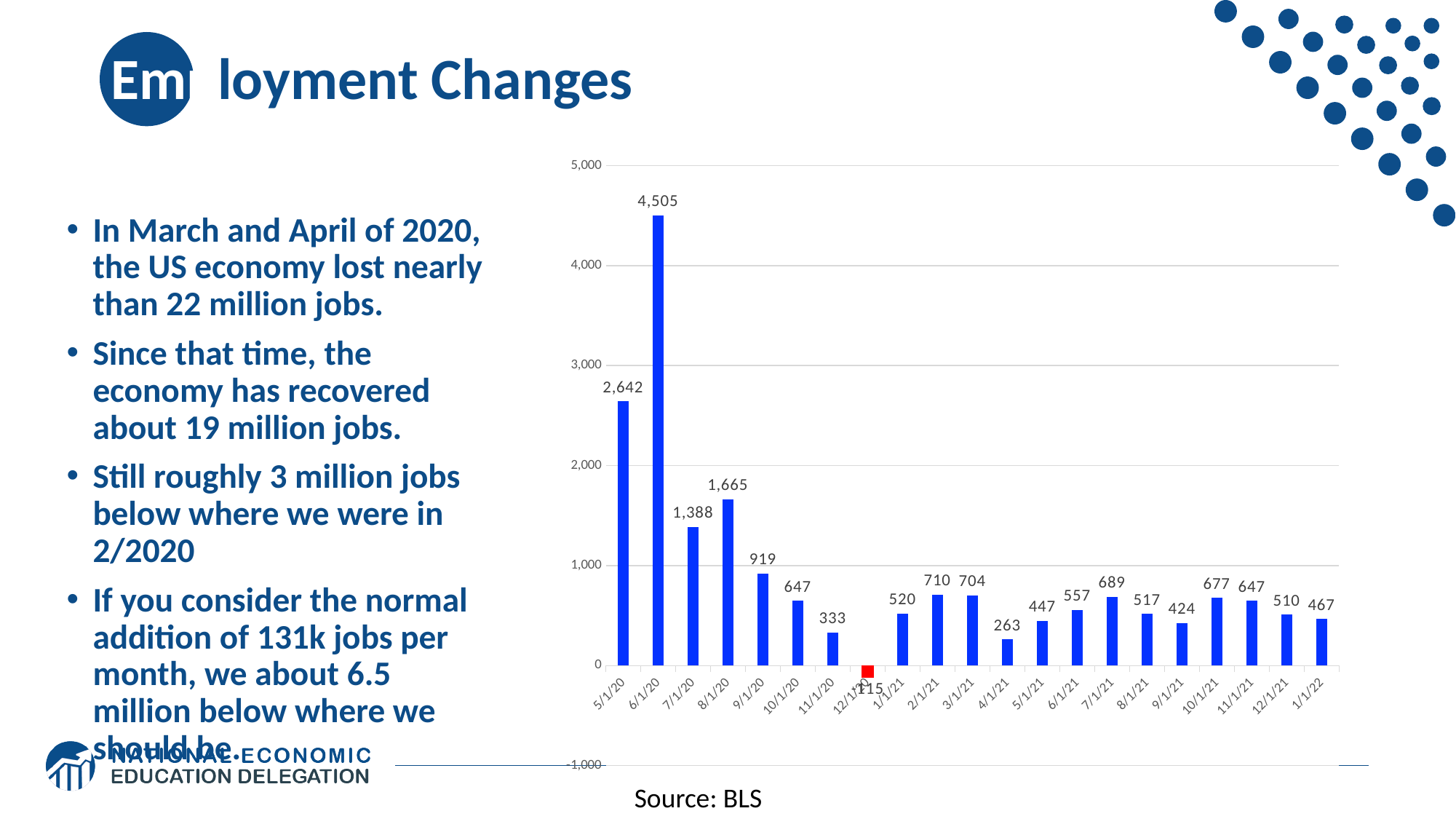
What is the difference between the values for 10/1/21 and 11/1/21? 30 Is the value for 8/1/20 greater or less than 1,000? greater What source is cited below the chart? BLS What is the value for 4/1/21? 263 What is the value for 5/1/20? 2,642 What is the value for 1/1/22? 467 What kind of chart is shown on the slide? Bar chart Which month has the highest value? 6/1/20 What is the difference between the values for 6/1/20 and 5/1/20? 1,863 What is the value for 6/1/20? 4,505 How many months (bars) are plotted in the chart? 21 Which is larger, the value for 2/1/21 or the value for 3/1/21? 2/1/21